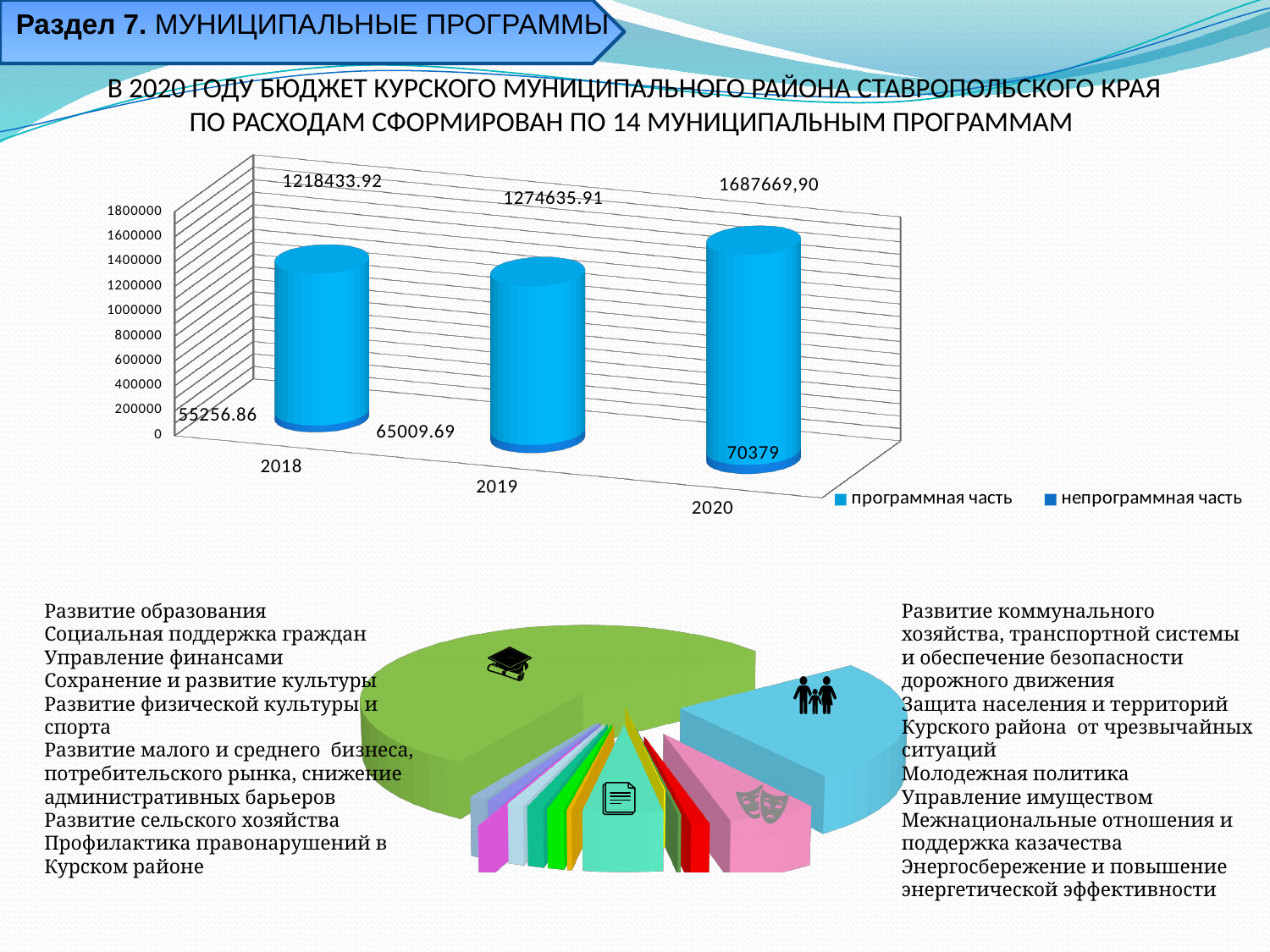
In the bar chart at the top of the slide, what is the value of программная часть for 2020? 1687669,90 In the bar chart at the top of the slide, which is larger: программная часть in 2018 or in 2019? 2019 In the bar chart at the top of the slide, what is the value of непрограммная часть for 2020? 70379 How many years are shown on the x axis of the bar chart at the top of the slide? 3 In the bar chart at the top of the slide, does the value of программная часть rise or fall from 2018 to 2020? rise In the bar chart at the top of the slide, what is the difference between the непрограммная часть values for 2019 and 2018? 9752.83 In the bar chart at the top of the slide, which year has the lowest value for непрограммная часть? 2018 How many series does the legend of the bar chart at the top of the slide list? 2 In the bar chart at the top of the slide, which year has the highest value for программная часть? 2020 In the bar chart at the top of the slide, what is the value of программная часть for 2019? 1274635.91 In the bar chart at the top of the slide, is the value of программная часть for 2020 greater or less than 1600000? greater In the bar chart at the top of the slide, what is the value of непрограммная часть for 2018? 55256.86